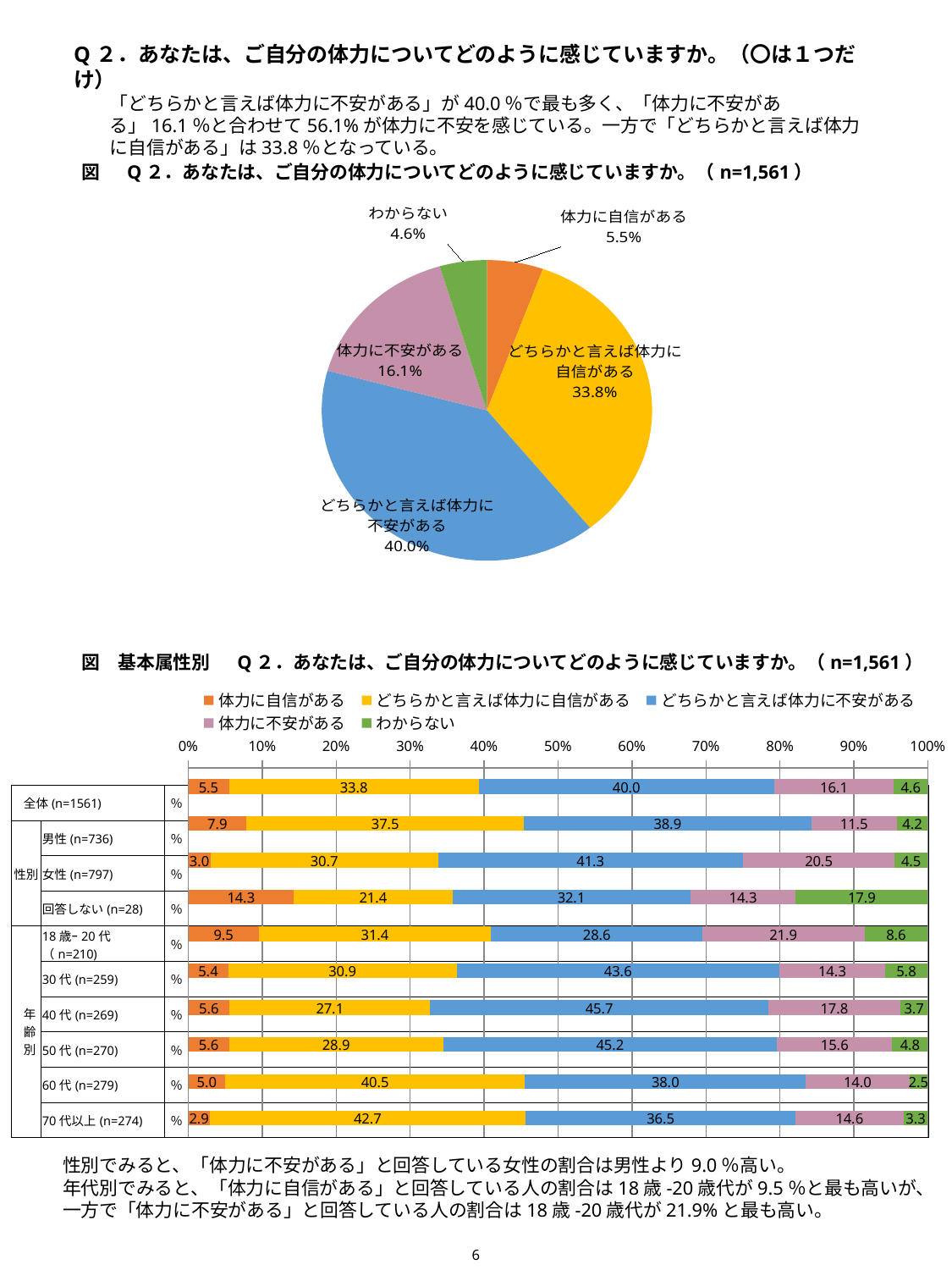
In the pie chart at the top of the slide, which category has the smallest slice? わからない In the lower bar chart (基本属性別), what is the value of 「体力に不安がある」 for 女性 (n=797)? 20.5 What kind of chart is the lower chart on the slide (基本属性別)? Stacked bar chart In the lower bar chart (基本属性別), how many series does the legend list? 5 In the pie chart at the top of the slide, what share is shown for 「どちらかと言えば体力に不安がある」? 40.0% In the pie chart at the top of the slide, how many slices are there? 5 In the pie chart at the top of the slide, what is the difference between the shares for 「体力に不安がある」 and 「体力に自信がある」? 10.6% In the lower bar chart (基本属性別), is the value of 「体力に自信がある」 larger for 男性 (n=736) or 女性 (n=797)? 男性 (n=736) In the lower bar chart (基本属性別), which row has the highest value for 「わからない」? 回答しない (n=28) In the pie chart at the top of the slide, which category has the largest slice? どちらかと言えば体力に不安がある In the lower bar chart (基本属性別), what is the difference between the 「体力に不安がある」 values for 女性 (n=797) and 男性 (n=736)? 9.0 In the lower bar chart (基本属性別), what is the value of 「どちらかと言えば体力に自信がある」 for 70代以上 (n=274)? 42.7